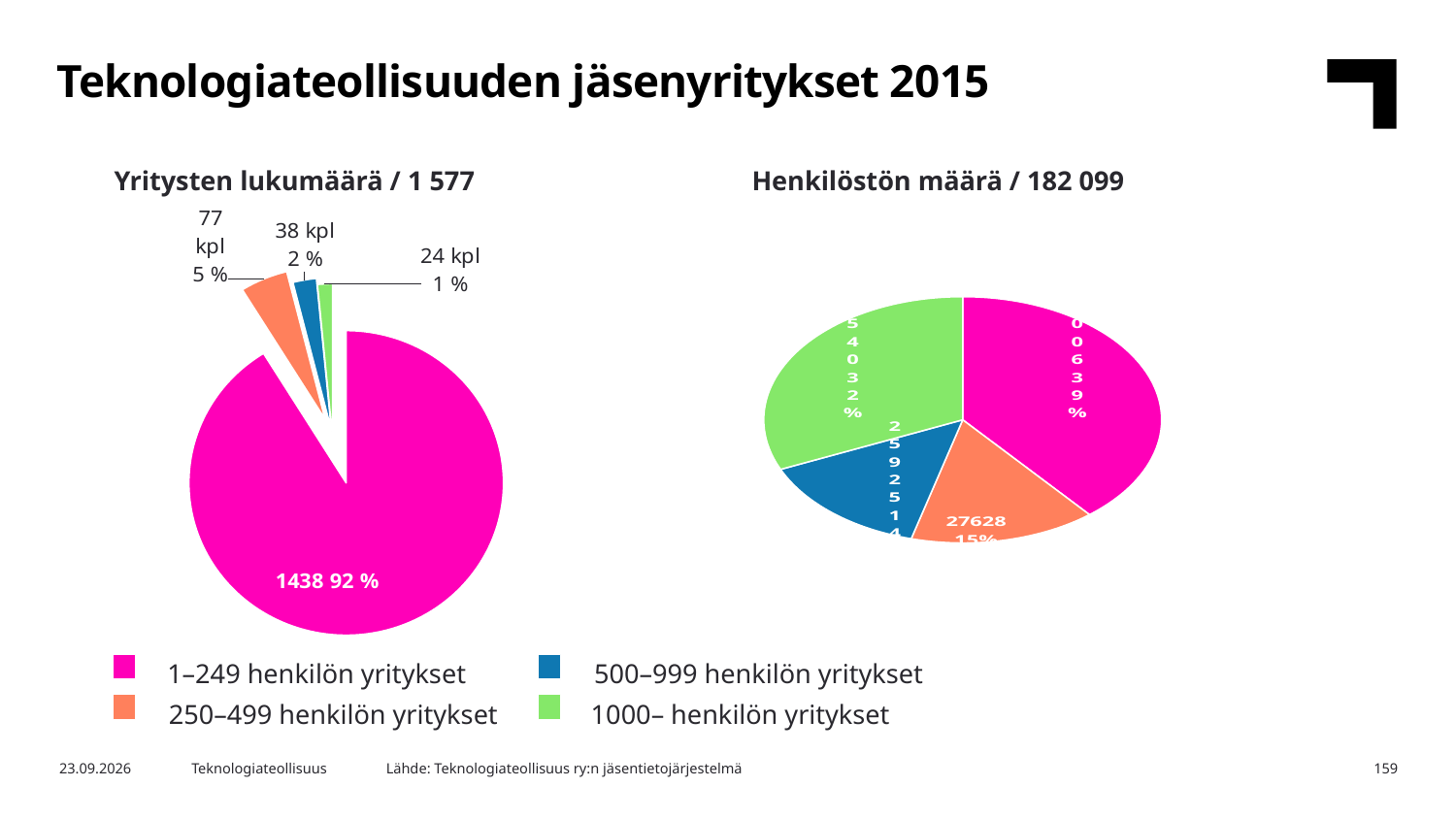
On the left chart (Yritysten lukumäärä), what is the difference in company count between the 250–499 and 500–999 categories? 39 On the left chart (Yritysten lukumäärä), how many companies are in the 250–499 henkilön yritykset category? 77 kpl What type of chart is used on the right side of the slide (Henkilöstön määrä)? Pie chart On the left chart (Yritysten lukumäärä), what percentage share do 1–249 henkilön yritykset have? 92 % On the left chart (Yritysten lukumäärä), how many companies are in the 1–249 henkilön yritykset category? 1438 On the left chart (Yritysten lukumäärä), which category has the smallest slice? 1000– henkilön yritykset On the left chart (Yritysten lukumäärä), how many companies are in the 1000– henkilön yritykset category? 24 kpl On the left chart (Yritysten lukumäärä), which category has the largest slice? 1–249 henkilön yritykset On the left chart (Yritysten lukumäärä), which has more companies: 500–999 henkilön yritykset or 1000– henkilön yritykset? 500–999 henkilön yritykset What is the title of the right chart? Henkilöstön määrä / 182 099 How many categories does the legend list? 4 On the left chart (Yritysten lukumäärä), what percentage share do 500–999 henkilön yritykset have? 2 %